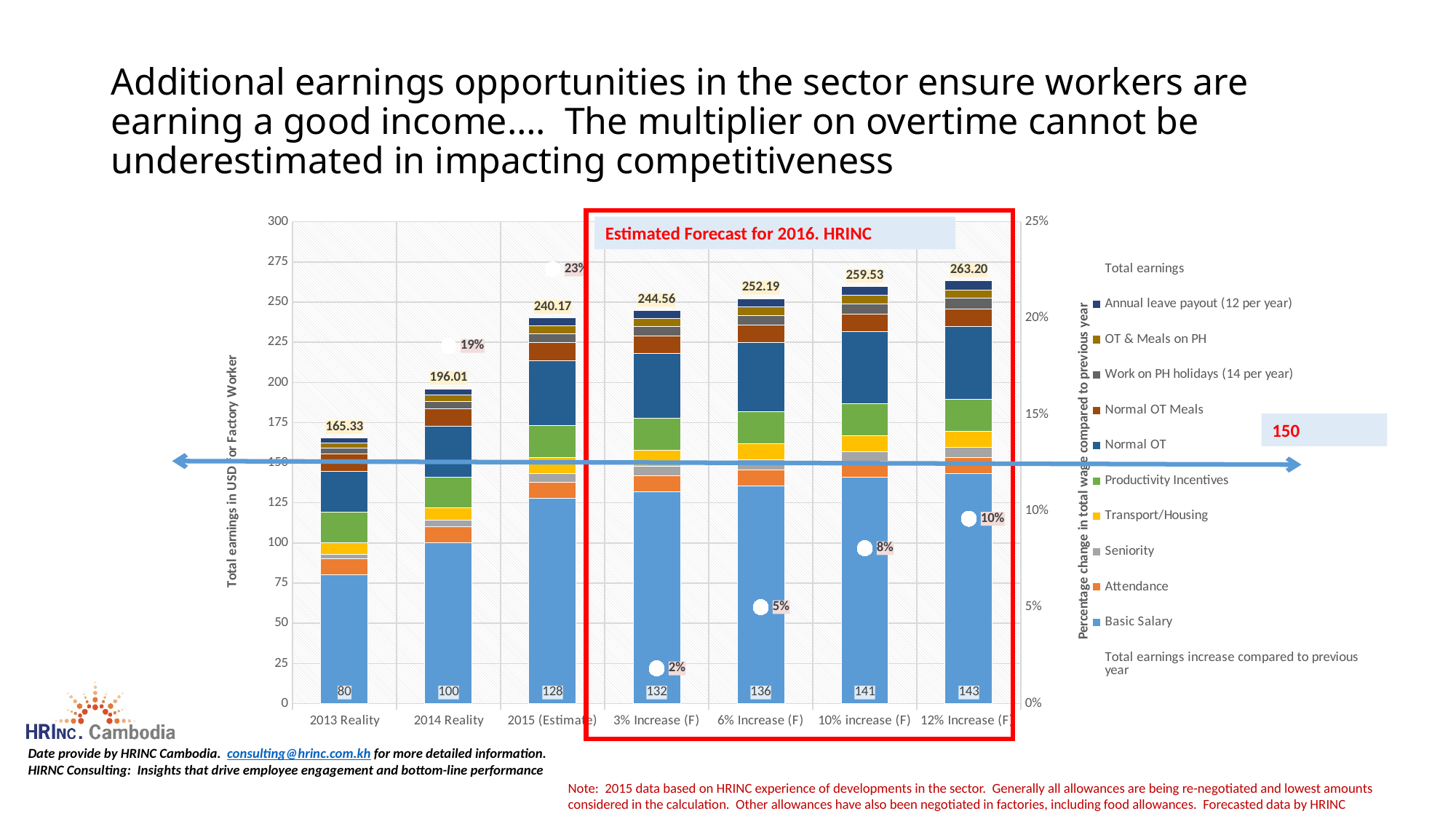
What is the Basic Salary value labelled for the 12% Increase (F) bar? 143 Which category has the highest total earnings? 12% Increase (F) Which category has the lowest Basic Salary? 2013 Reality Do the total earnings values rise or fall from 2013 Reality to 12% Increase (F)? rise What is the difference in total earnings between 2014 Reality and 2013 Reality? 30.68 How many categories are shown on the x axis? 7 What is the difference in Basic Salary between the 10% increase (F) and 3% Increase (F) bars? 9 What is the total earnings value shown for 2014 Reality? 196.01 What total earnings value is labelled above the 2015 (Estimate) bar? 240.17 What percentage change in total wage is shown for the 6% Increase (F) scenario? 5% What kind of chart is used to show the earnings components? stacked bar chart Which is larger, the total earnings for 3% Increase (F) or for 6% Increase (F)? 6% Increase (F)